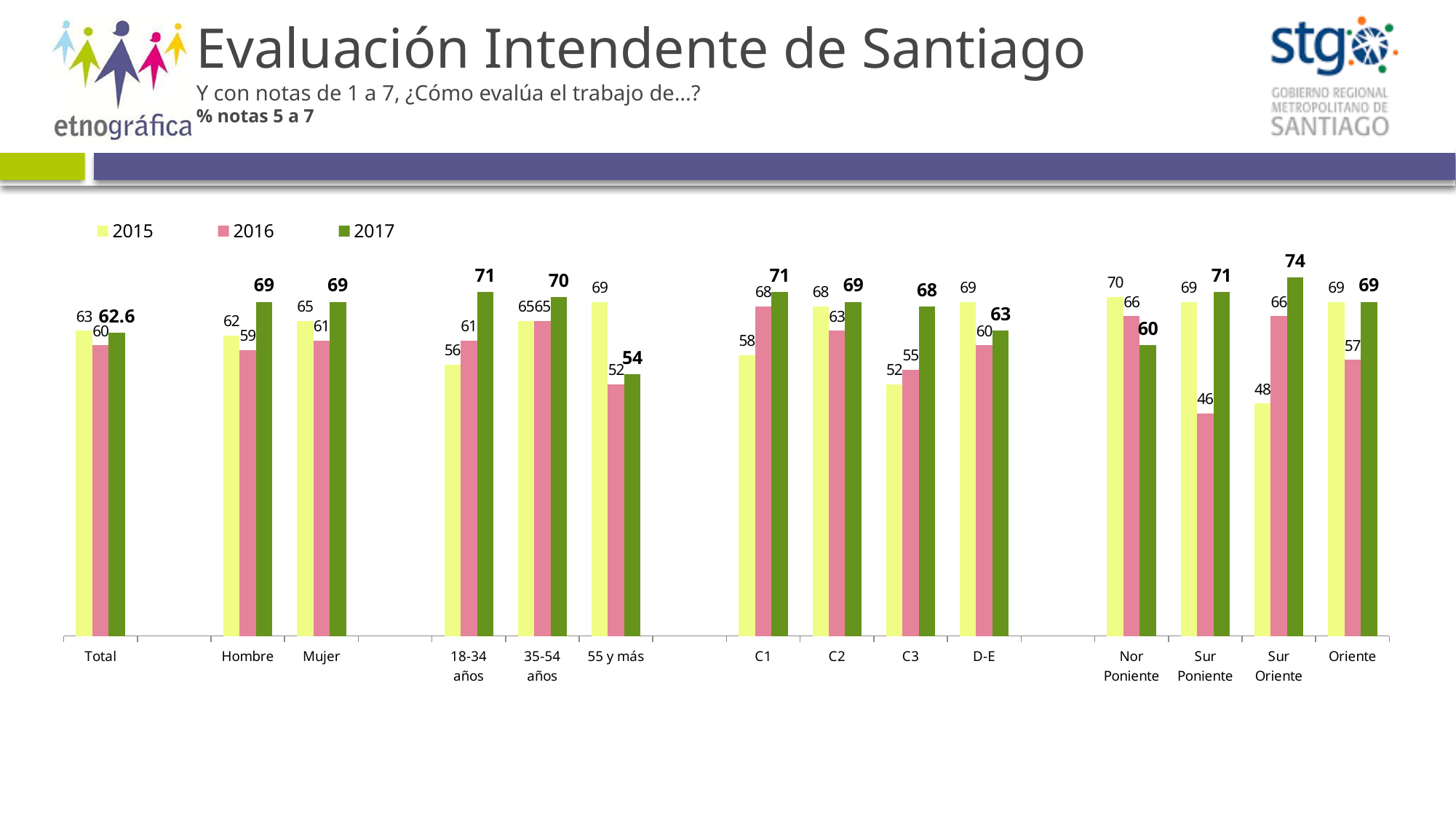
How many categories are shown on the x axis? 14 What is the difference between the 2017 and 2015 values for Sur Oriente? 26 Which is larger for 55 y más: the 2015 value or the 2017 value? 2015 What is the 2015 value for 18-34 años? 56 What is the 2017 value for Total? 62.6 What is the 2017 value for Sur Oriente? 74 Which series is shown in dark green in the legend? 2017 Which category has the highest 2017 value? Sur Oriente How many series does the legend list? 3 Which category has the lowest 2016 value? Sur Poniente What is the 2016 value for Sur Poniente? 46 What kind of chart is shown on the slide? Bar chart